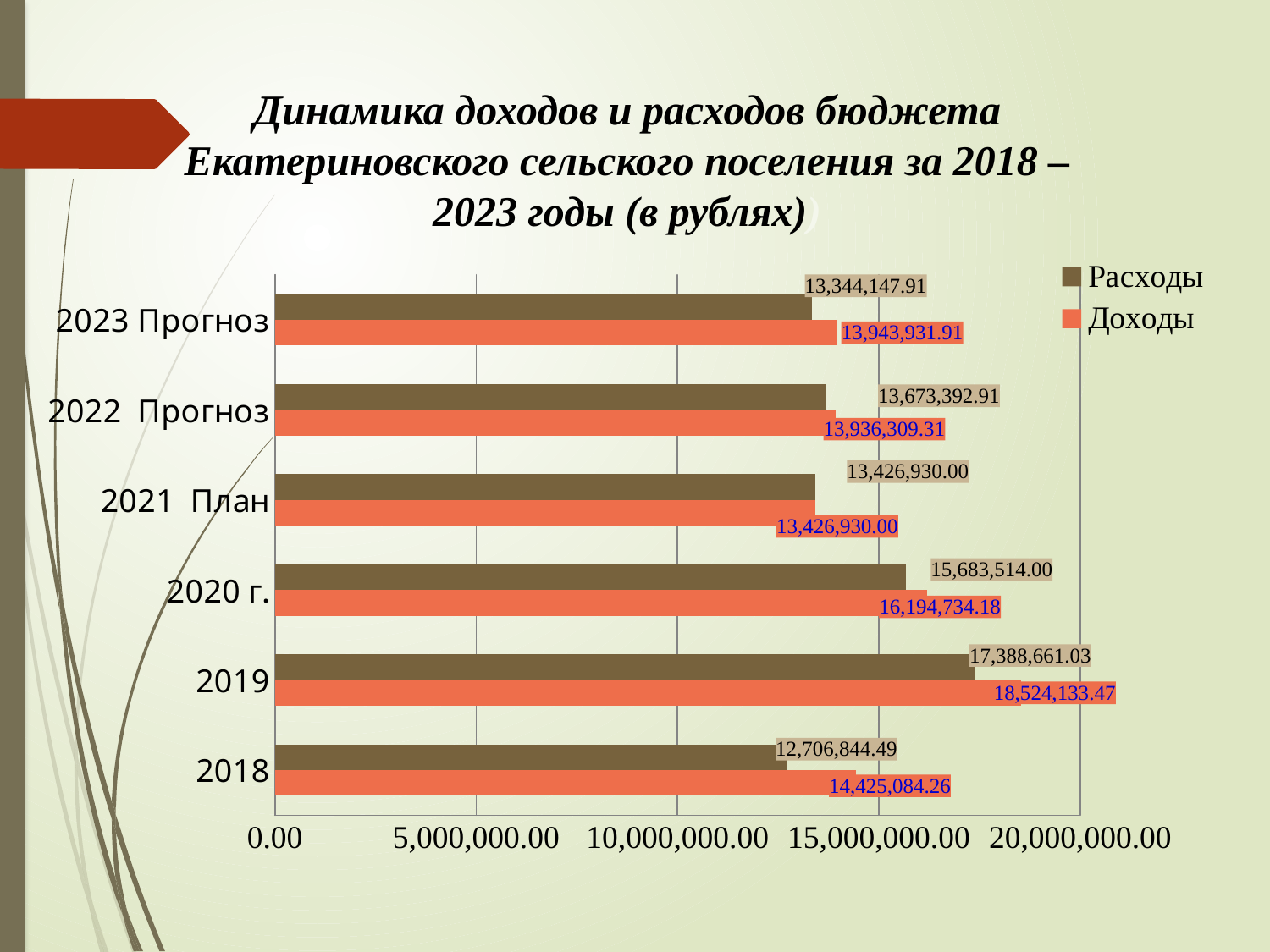
What is the value of Доходы for 2018? 14,425,084.26 How many series does the legend list? 2 Which is larger: Расходы for 2020 г. or Расходы for 2018? Расходы for 2020 г. What is the value of Расходы for 2020 г.? 15,683,514.00 What is the value of Расходы for 2023 Прогноз? 13,344,147.91 What is the difference between Доходы and Расходы for 2019? 1,135,472.44 Which category has the lowest Расходы value? 2018 What is the difference between Доходы and Расходы for 2018? 1,718,239.77 Is the Доходы value for 2019 greater or less than 15,000,000.00? greater How many categories are shown on the chart? 6 What is the value of Доходы for 2021 План? 13,426,930.00 Which category has the highest Доходы value? 2019